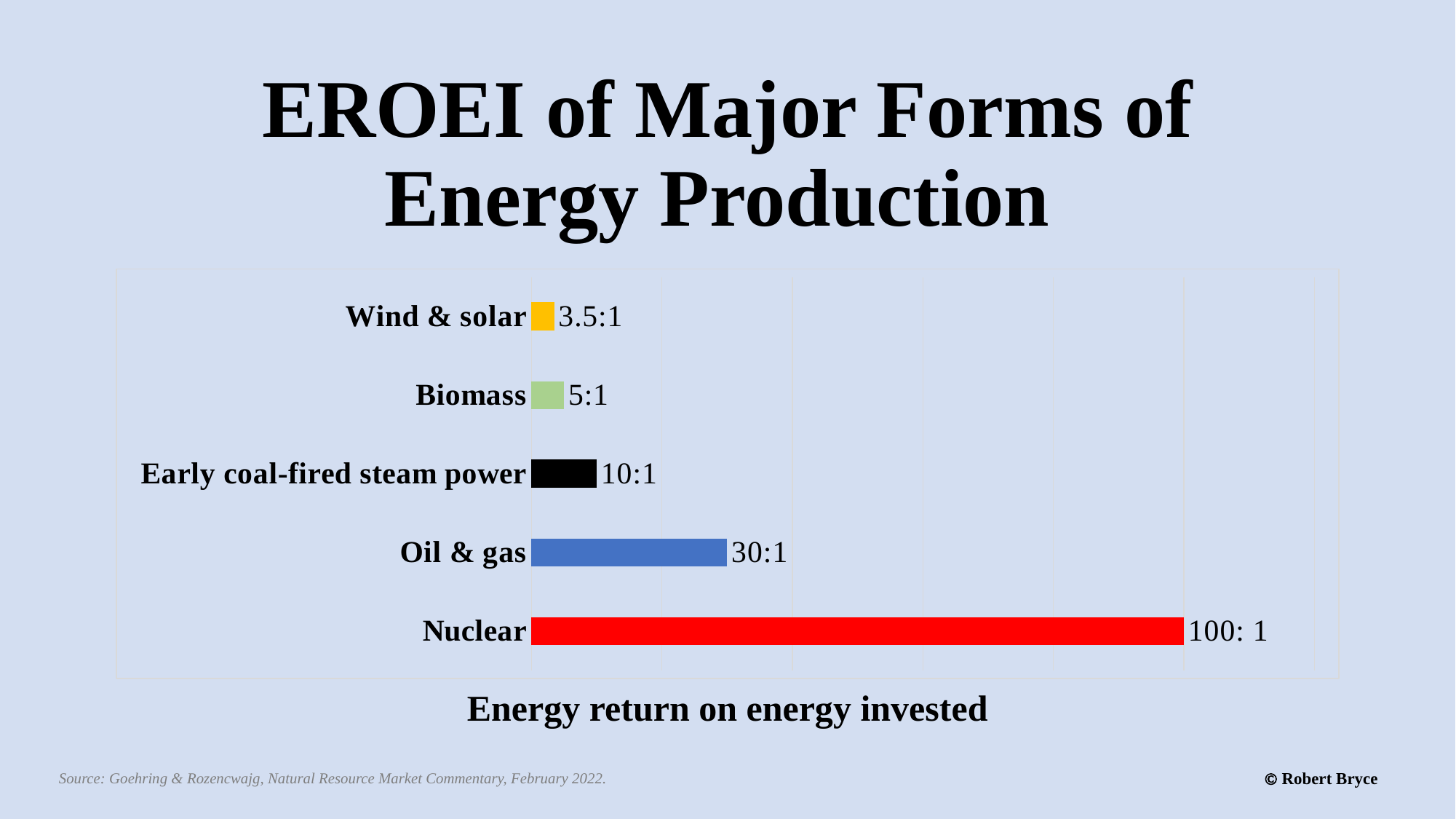
What is the title of the chart on the slide? EROEI of Major Forms of Energy Production What is the EROEI value shown for Nuclear? 100: 1 Which has a higher EROEI, Oil & gas or Early coal-fired steam power? Oil & gas What is the EROEI value shown for Early coal-fired steam power? 10:1 Which energy form has the lowest EROEI on the chart? Wind & solar What colour is the bar for Nuclear? Red What is the EROEI value shown for Oil & gas? 30:1 How many energy forms are shown on the chart? 5 Which energy form has the highest EROEI on the chart? Nuclear What is the EROEI value shown for Biomass? 5:1 What kind of chart is shown on the slide? Bar chart What is the EROEI value shown for Wind & solar? 3.5:1